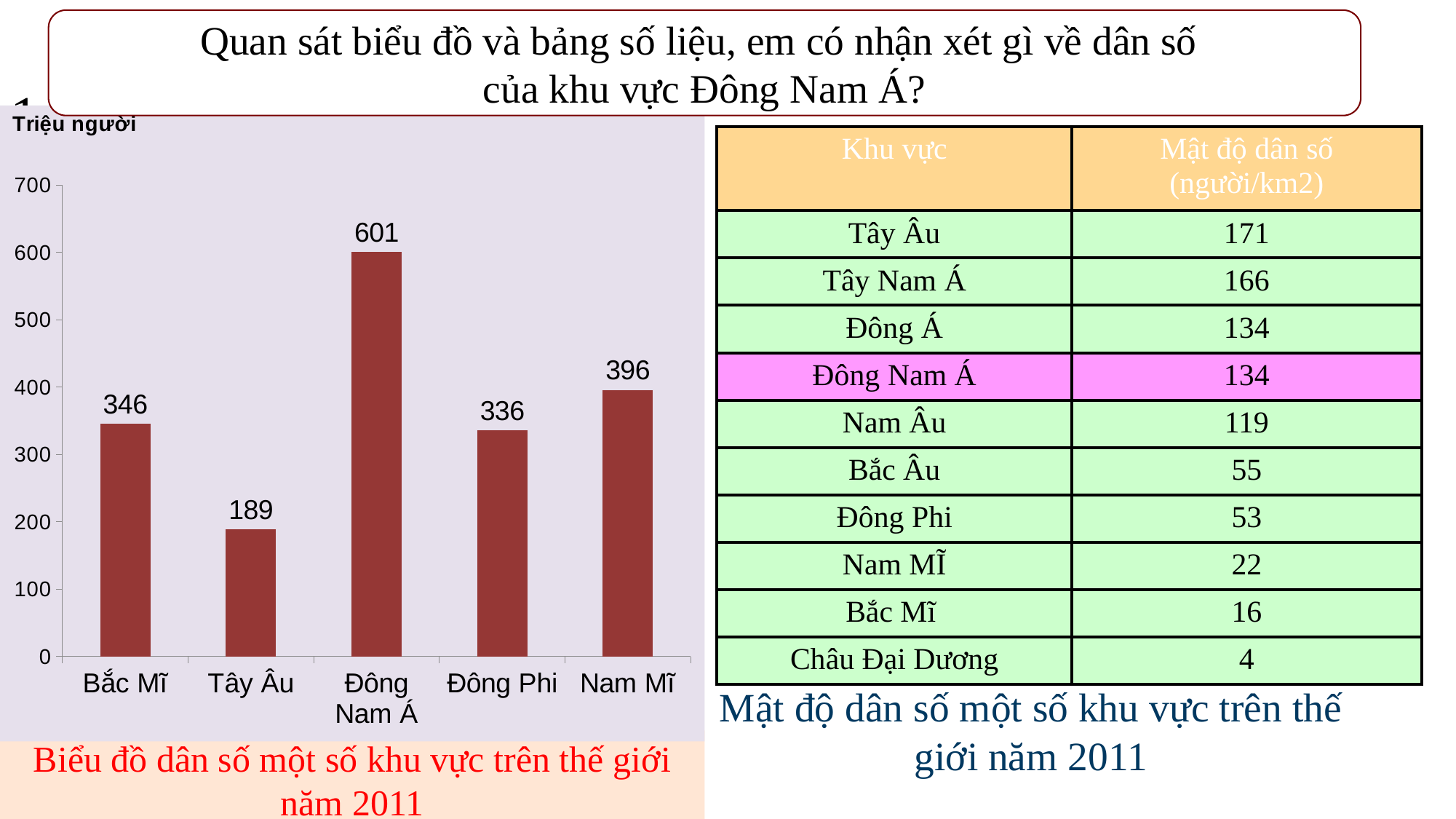
What is the difference between the values for Nam Mĩ and Đông Phi in the bar chart? 60 Is the value for Nam Mĩ in the bar chart greater or less than 300? greater Which region has the highest value in the bar chart? Đông Nam Á In the bar chart, which is larger: the value for Bắc Mĩ or the value for Đông Phi? Bắc Mĩ What is the value for Đông Nam Á in the bar chart? 601 What unit is shown on the vertical axis of the bar chart? Triệu người How many regions are shown in the bar chart? 5 Which region has the lowest value in the bar chart? Tây Âu What kind of chart is shown on the left of the slide? bar chart What is the difference between the values for Đông Nam Á and Bắc Mĩ in the bar chart? 255 What is the value for Nam Mĩ in the bar chart? 396 What is the value for Tây Âu in the bar chart? 189